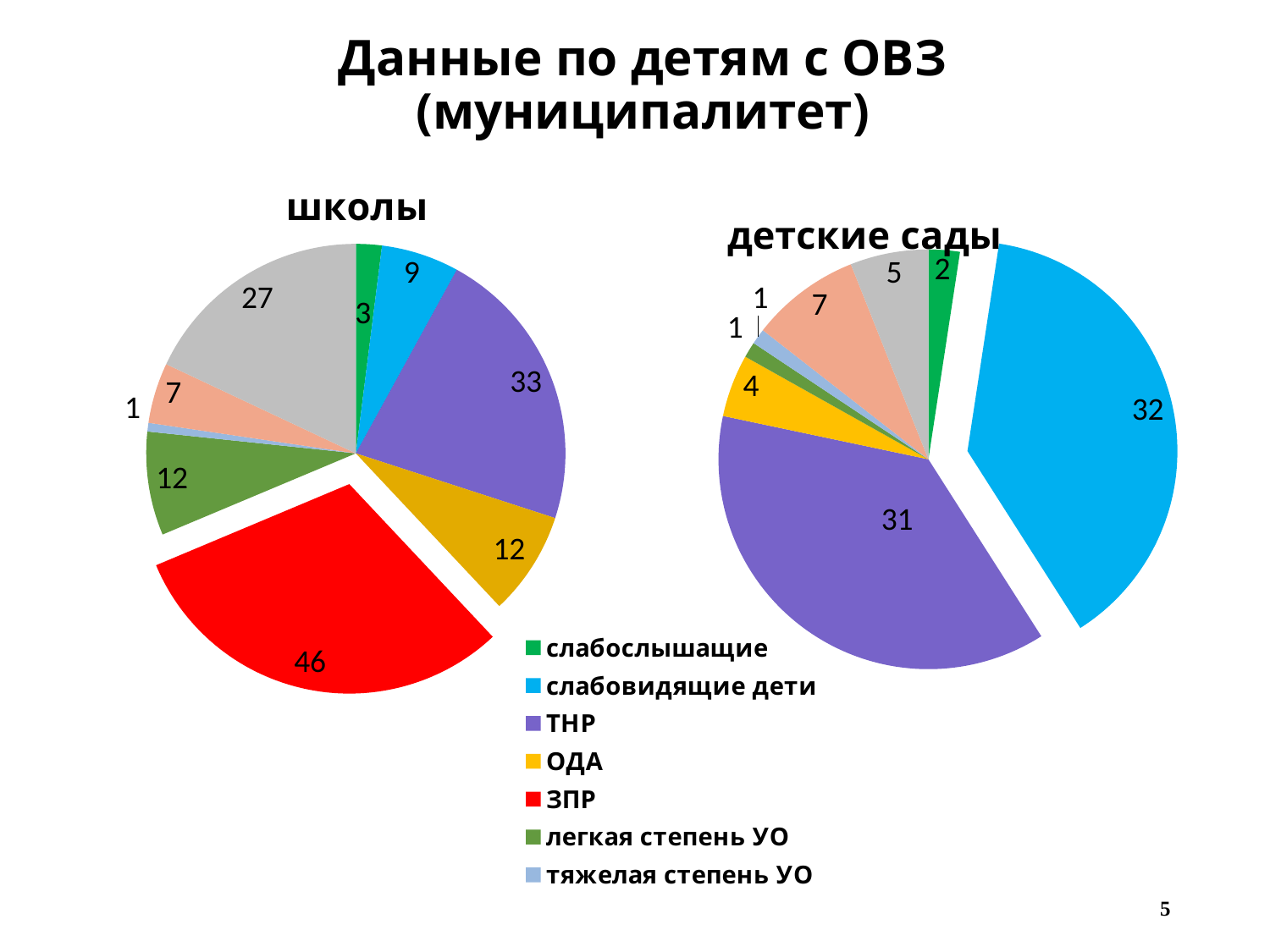
In the 'школы' pie chart, what is the value for ТНР? 33 In the 'школы' pie chart, what is the value for ЗПР? 46 In the 'школы' pie chart, what is the difference between the values for ЗПР and ТНР? 13 In the 'школы' pie chart, which is larger: ОДА or слабовидящие дети? ОДА In the 'школы' pie chart, which category has the largest slice? ЗПР In the 'детские сады' pie chart, what is the difference between the values for слабовидящие дети and ТНР? 1 In the 'детские сады' pie chart, what is the value for ОДА? 4 In the 'школы' pie chart, what is the value for слабослышащие? 3 How many entries does the legend list? 7 In the 'детские сады' pie chart, which category has the largest slice? слабовидящие дети In the 'детские сады' pie chart, what is the value for слабовидящие дети? 32 What type of chart is used for 'школы' and 'детские сады'? pie chart